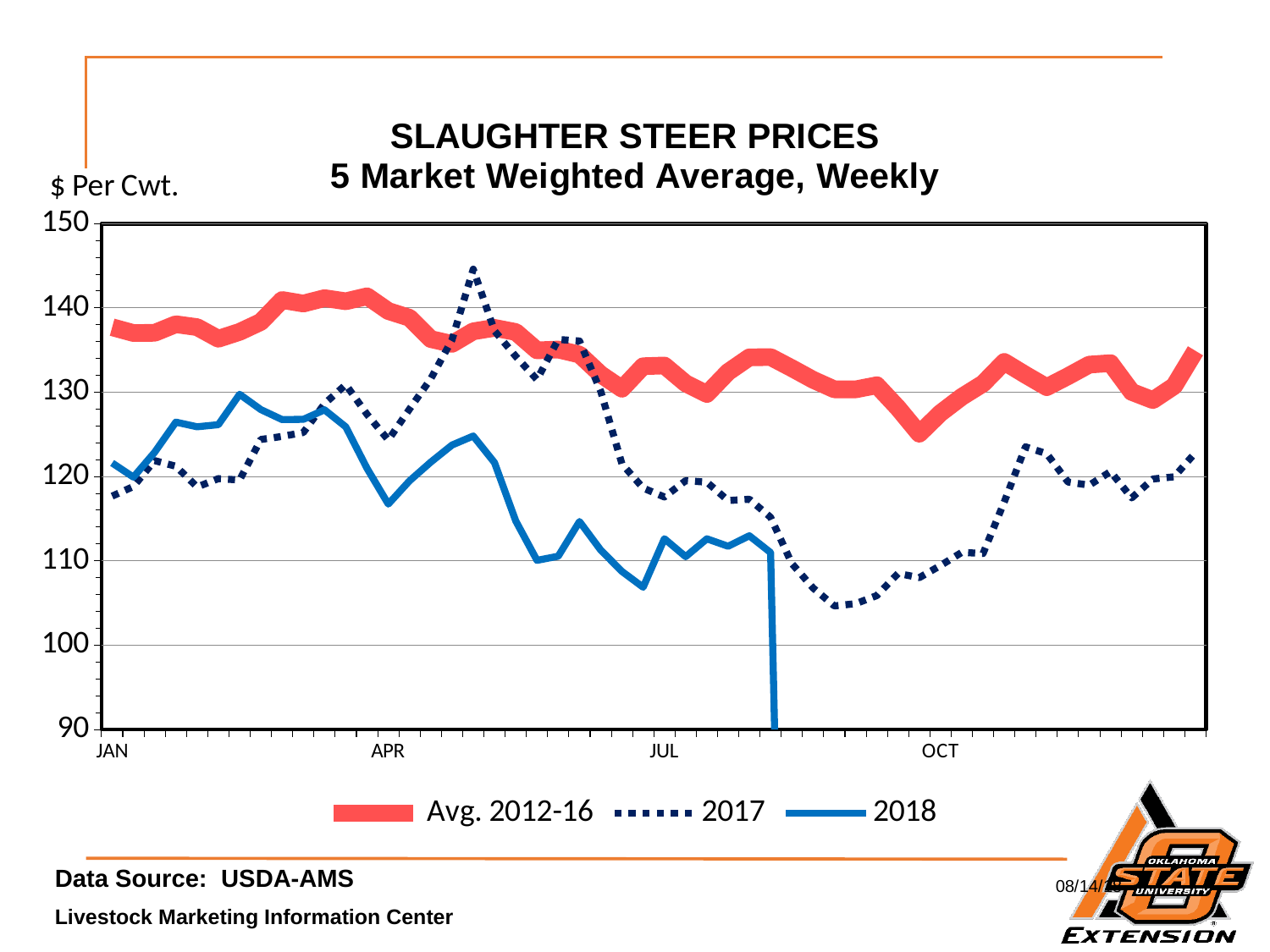
Is the value for the Avg. 2012-16 series in JAN greater or less than 130? greater What unit is shown on the y axis label? $ Per Cwt. Which series reaches the highest value anywhere on the chart? 2017 How many series does the legend list? 3 Is the peak value of the 2017 series (around late April) greater or less than 140? greater Is the lowest value of the 2017 series (around September) greater or less than 110? less Which series has the higher value in JAN, Avg. 2012-16 or 2018? Avg. 2012-16 What kind of chart is shown on the slide? line chart Does the 2018 series rise or fall between late April and JUL? fall Which series has the higher value at APR, 2017 or 2018? 2017 What are the three series named in the legend? Avg. 2012-16, 2017, 2018